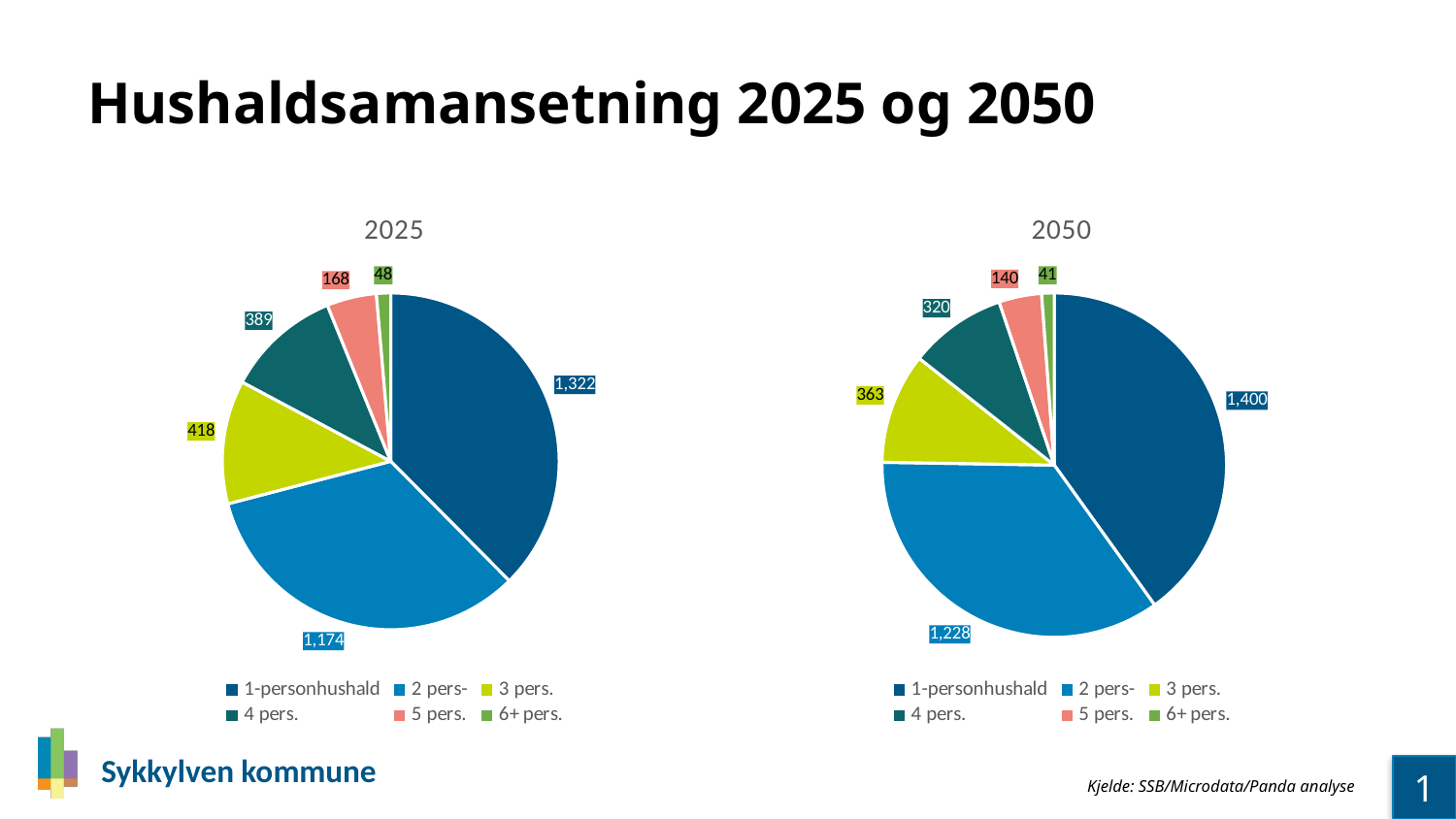
What is the difference between the 1-personhushald value in the 2050 chart and in the 2025 chart? 78 In the 2025 chart, what is the value for 4 pers.? 389 How many slices does the 2025 chart have? 6 How many entries does the legend of the 2050 chart list? 6 In the 2050 chart, which is larger, 3 pers. or 4 pers.? 3 pers. What kind of chart is the 2025 chart? pie chart In the 2050 chart, what is the value for 2 pers-? 1,228 In the 2050 chart, which category has the largest slice? 1-personhushald In the 2050 chart, what is the value for 6+ pers.? 41 In the 2025 chart, what is the difference between the 1-personhushald value and the 2 pers- value? 148 In the 2025 chart, what is the value for 1-personhushald? 1,322 In the 2025 chart, which category has the smallest slice? 6+ pers.